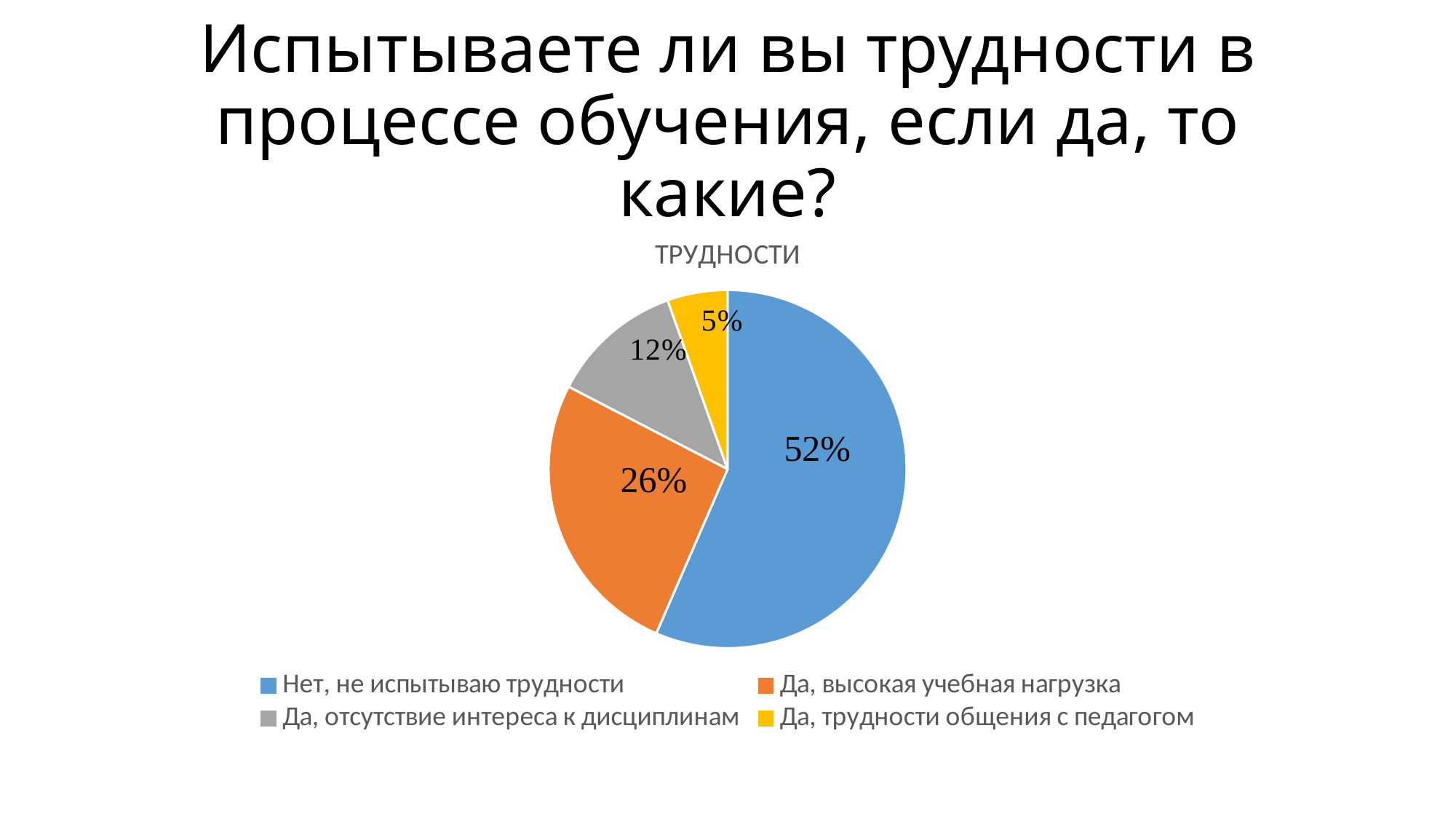
What colour is the slice for 'Да, высокая учебная нагрузка'? orange How many slices does the pie chart have? 4 Which category has the smallest slice? Да, трудности общения с педагогом What share of the pie is 'Да, отсутствие интереса к дисциплинам'? 12% Which category has the largest slice? Нет, не испытываю трудности What is the chart's title? ТРУДНОСТИ What share of the pie is 'Нет, не испытываю трудности'? 52% What share of the pie is 'Да, высокая учебная нагрузка'? 26% What kind of chart is shown on the slide? pie chart Which is larger: the share for 'Да, отсутствие интереса к дисциплинам' or 'Да, трудности общения с педагогом'? Да, отсутствие интереса к дисциплинам What is the difference between the shares for 'Нет, не испытываю трудности' and 'Да, высокая учебная нагрузка'? 26%